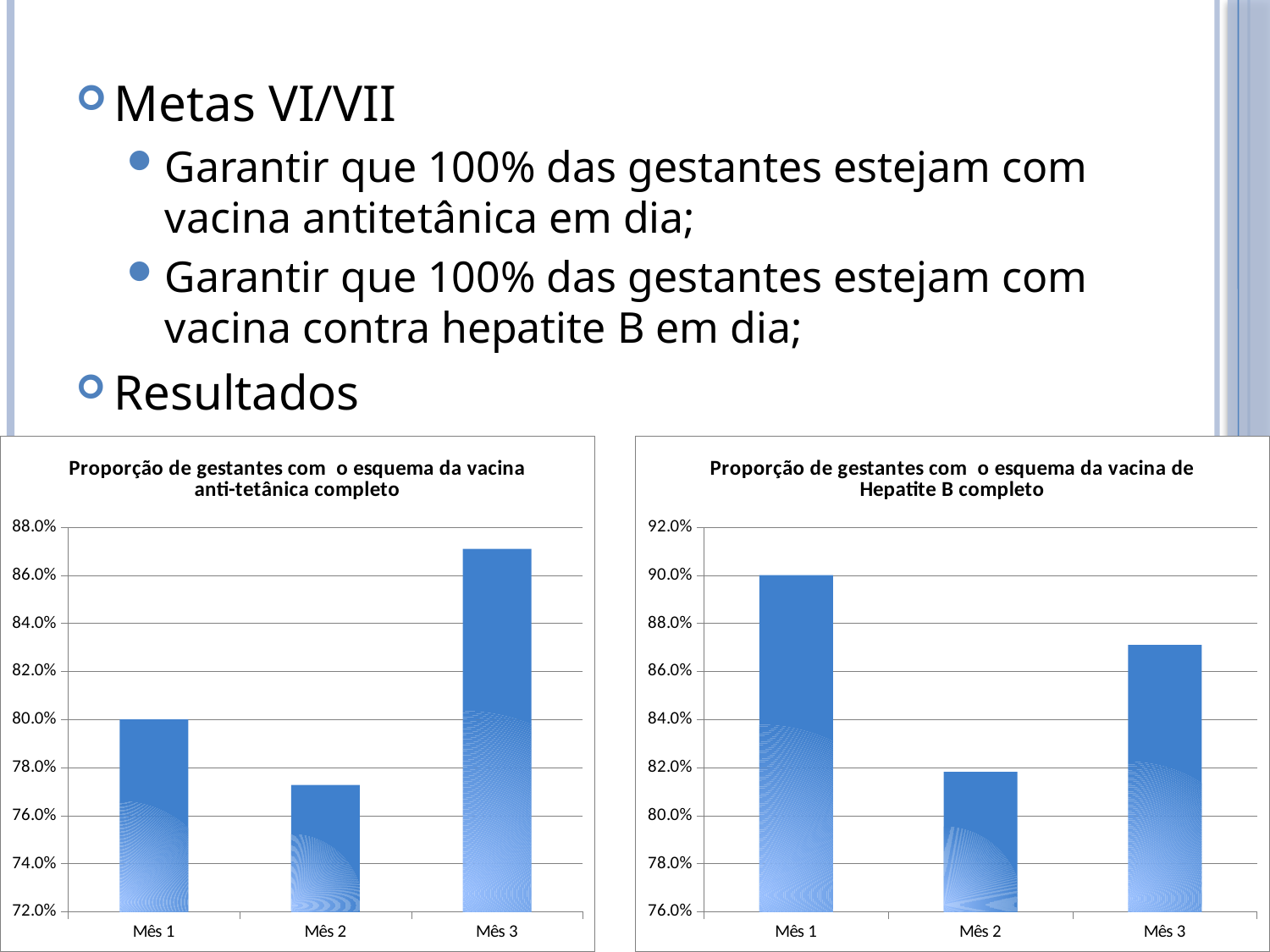
In the chart titled 'Proporção de gestantes com o esquema da vacina de Hepatite B completo', what is the value for Mês 1? 90.0% In the Hepatite B chart on the right, which month has the highest value? Mês 1 In the anti-tetânica chart on the left, is the value for Mês 2 greater or less than 78.0%? less In the anti-tetânica chart on the left, which month has the highest value? Mês 3 In the Hepatite B chart on the right, which month has the lowest value? Mês 2 In the chart titled 'Proporção de gestantes com o esquema da vacina anti-tetânica completo', what is the value for Mês 1? 80.0% In the Hepatite B chart on the right, is the value for Mês 2 greater or less than 84.0%? less In the Hepatite B chart on the right, which is larger, the value for Mês 1 or the value for Mês 3? Mês 1 How many months are shown on the x axis of the anti-tetânica chart on the left? 3 In the anti-tetânica chart on the left, is the value for Mês 3 greater or less than 86.0%? greater In the anti-tetânica chart on the left, which month has the lowest value? Mês 2 What kind of chart is the Hepatite B chart on the right? Bar chart